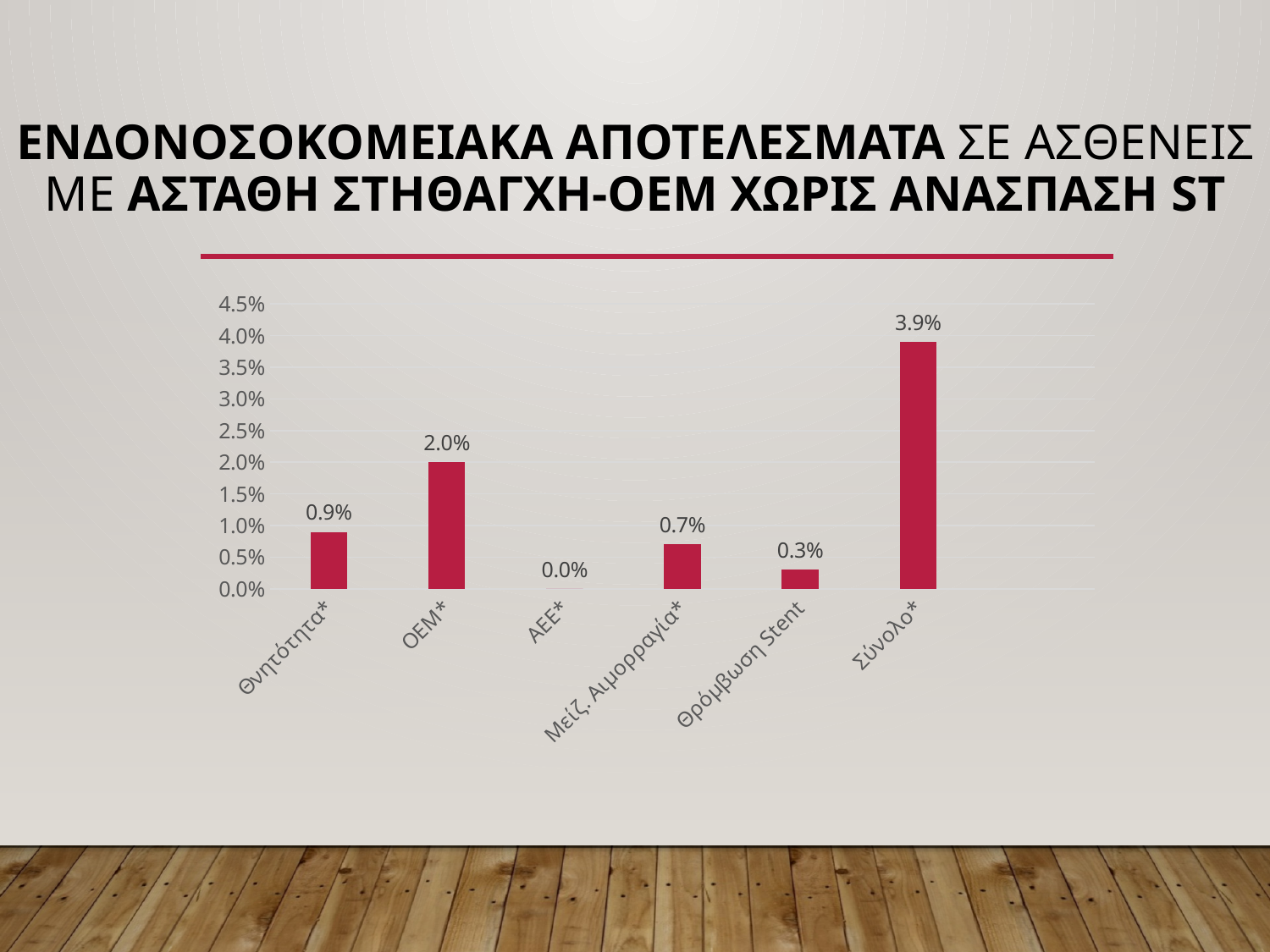
What is the highest value shown on the y axis? 4.5% Which category has the highest value? Σύνολο* How many categories are shown on the x axis? 6 What is the value for Θρόμβωση Stent? 0.3% What is the difference between the values for Σύνολο* and ΟΕΜ*? 1.9% Which category has the lowest value? ΑΕΕ* Which is larger, the value for Θνητότητα* or the value for Μείζ. Αιμορραγία*? Θνητότητα* What kind of chart is shown on the slide? Bar chart What is the value for Θνητότητα*? 0.9% What is the value for ΟΕΜ*? 2.0% What is the value for Μείζ. Αιμορραγία*? 0.7% What is the value for ΑΕΕ*? 0.0%